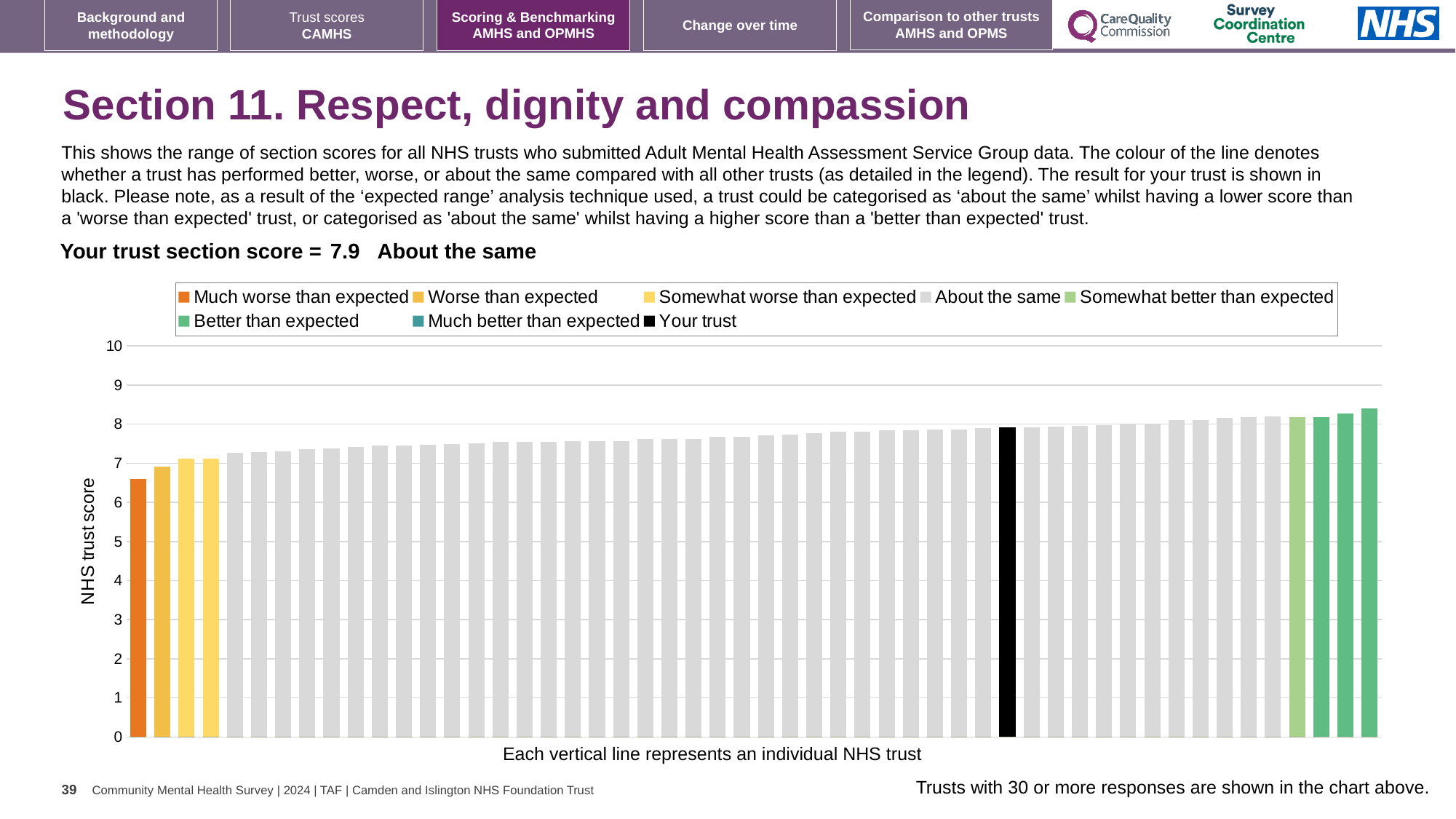
What is the section score for your trust shown on the slide? 7.9 Which category is your trust placed in for this section? About the same Is the value for the highest bar on the chart greater or less than 8? greater Which legend entry does the orange colour represent? Much worse than expected Is the value for your trust (the black bar) greater or less than 7? greater Is the value for the lowest bar (the orange bar) greater or less than 7? less What is the label of the y axis? NHS trust score What kind of chart is shown on the slide? bar chart Which is larger: the orange bar or the black bar? the black bar What is the highest value shown on the y axis? 10 Do the bar values rise or fall from left to right along the x axis? rise How many entries does the chart legend list? 8